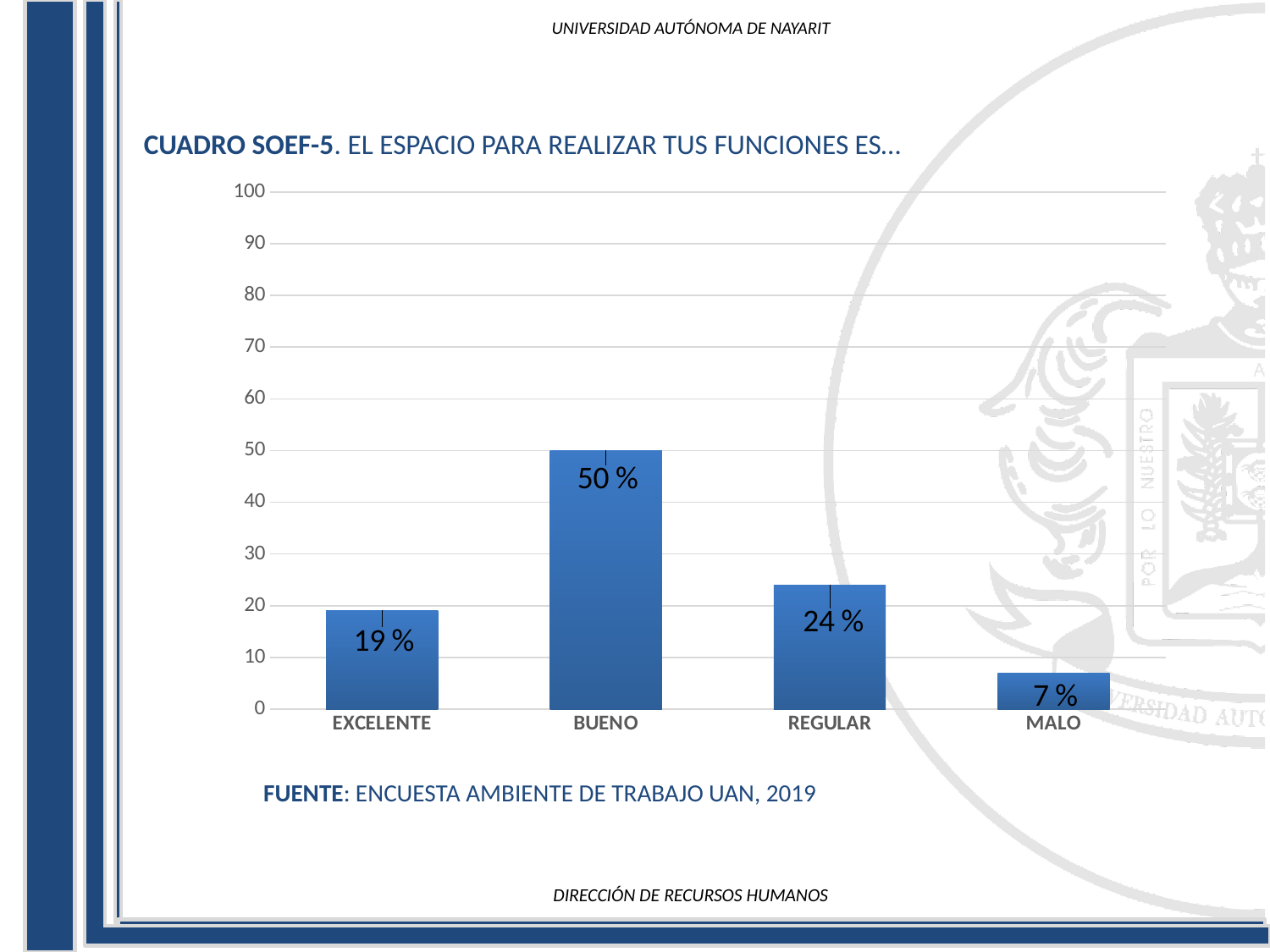
Which is larger, the value for EXCELENTE or the value for REGULAR? REGULAR What is the value for EXCELENTE? 19 % What is the difference between the values for BUENO and REGULAR? 26 % Which category has the highest value? BUENO What is the value for MALO? 7 % What is the source cited below the chart? ENCUESTA AMBIENTE DE TRABAJO UAN, 2019 Which category has the lowest value? MALO How many categories are shown on the x axis? 4 Is the value for REGULAR greater or less than 30? less What kind of chart is shown on the slide? bar chart What is the value for BUENO? 50 % What is the value for REGULAR? 24 %